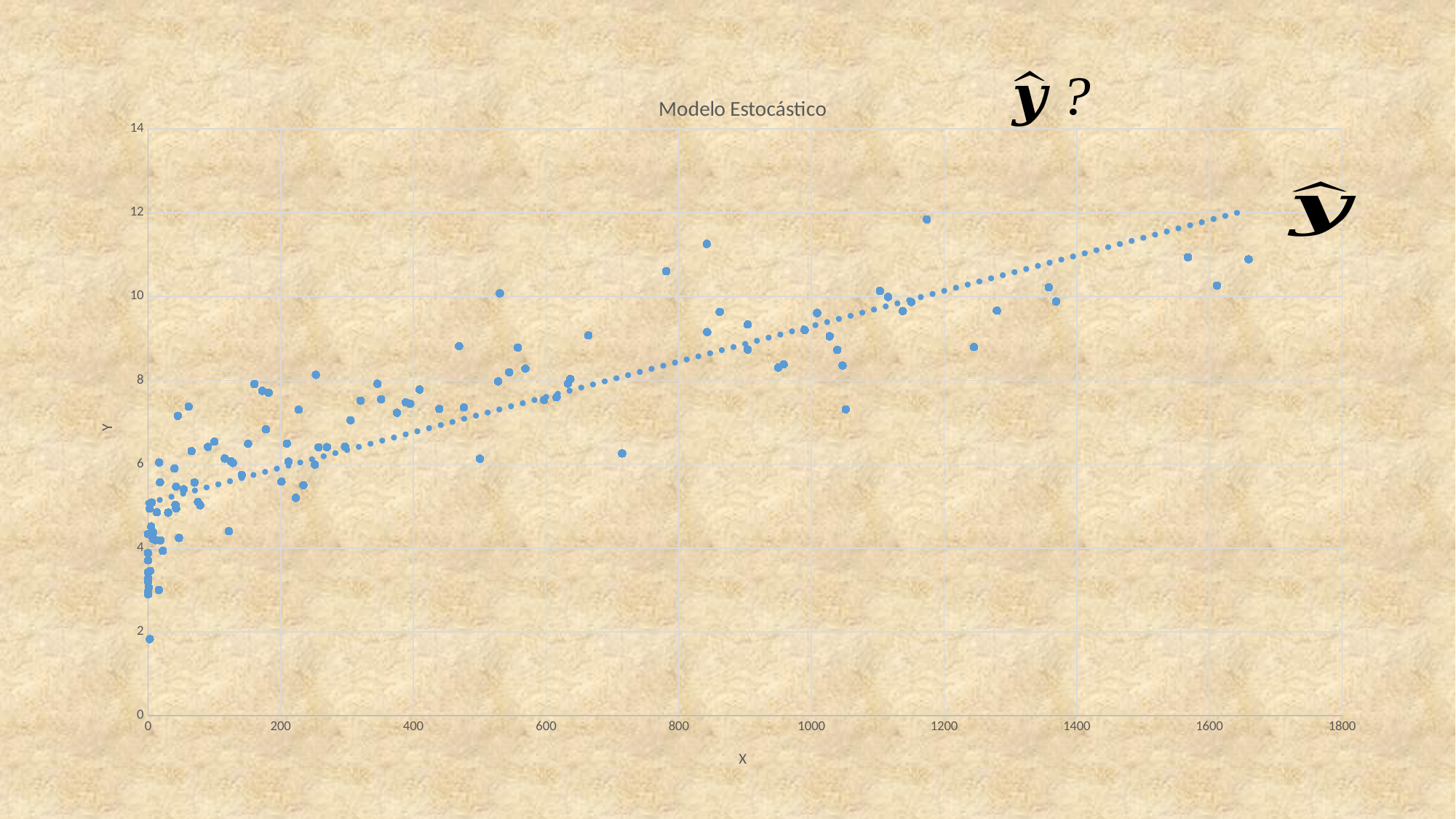
Is the lowest plotted point on the chart greater or less than 4 on the Y axis? less What is the title of the chart? Modelo Estocástico What are the labels of the horizontal and vertical axes of the chart? X and Y What kind of chart is shown on the slide? scatter chart Do the plotted Y values generally rise or fall as X increases? rise Is the value of the dotted trend line at X = 0 greater or less than 6? less Is the value of the dotted trend line at X = 1600 greater or less than 10? greater Is the dotted trend line higher at X = 200 or at X = 1600? X = 1600